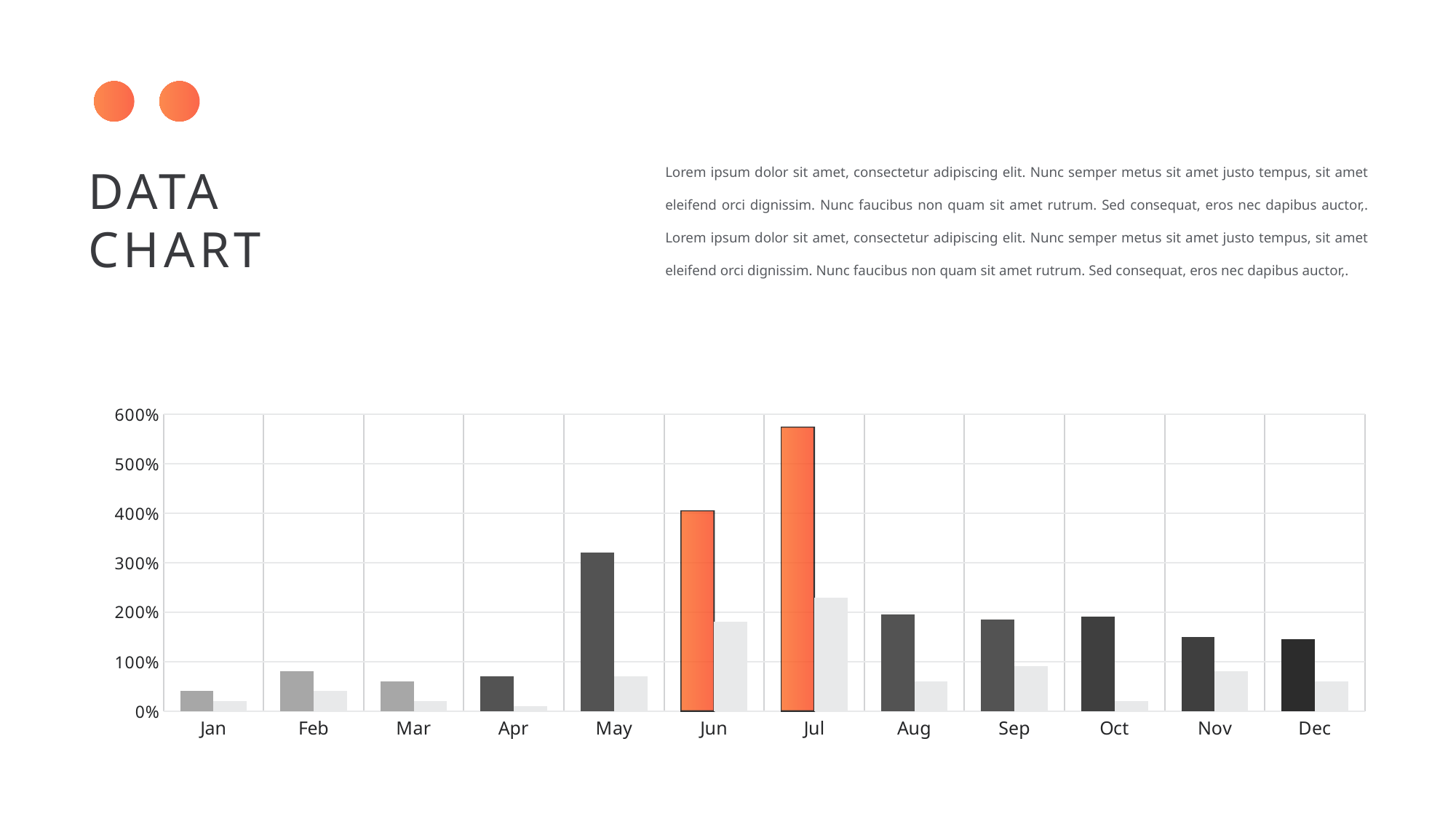
Is the value of the dark (first) bar for May greater or less than 300%? greater Which month has the shortest light grey (second) bar in the chart? Apr How many months are shown on the x axis of the chart? 12 What kind of chart is shown on the slide? bar chart Is the value of the tallest bar for Jul greater or less than 500%? greater Which month has the larger first bar, May or Jun? Jun Which month has the tallest bar in the chart? Jul Which two months have their first bars highlighted in orange? Jun and Jul Is the value of the light grey (second) bar for Jun greater or less than 200%? less Which month has the shortest dark (first) bar in the chart? Jan Which month has the larger first bar, Oct or Nov? Oct